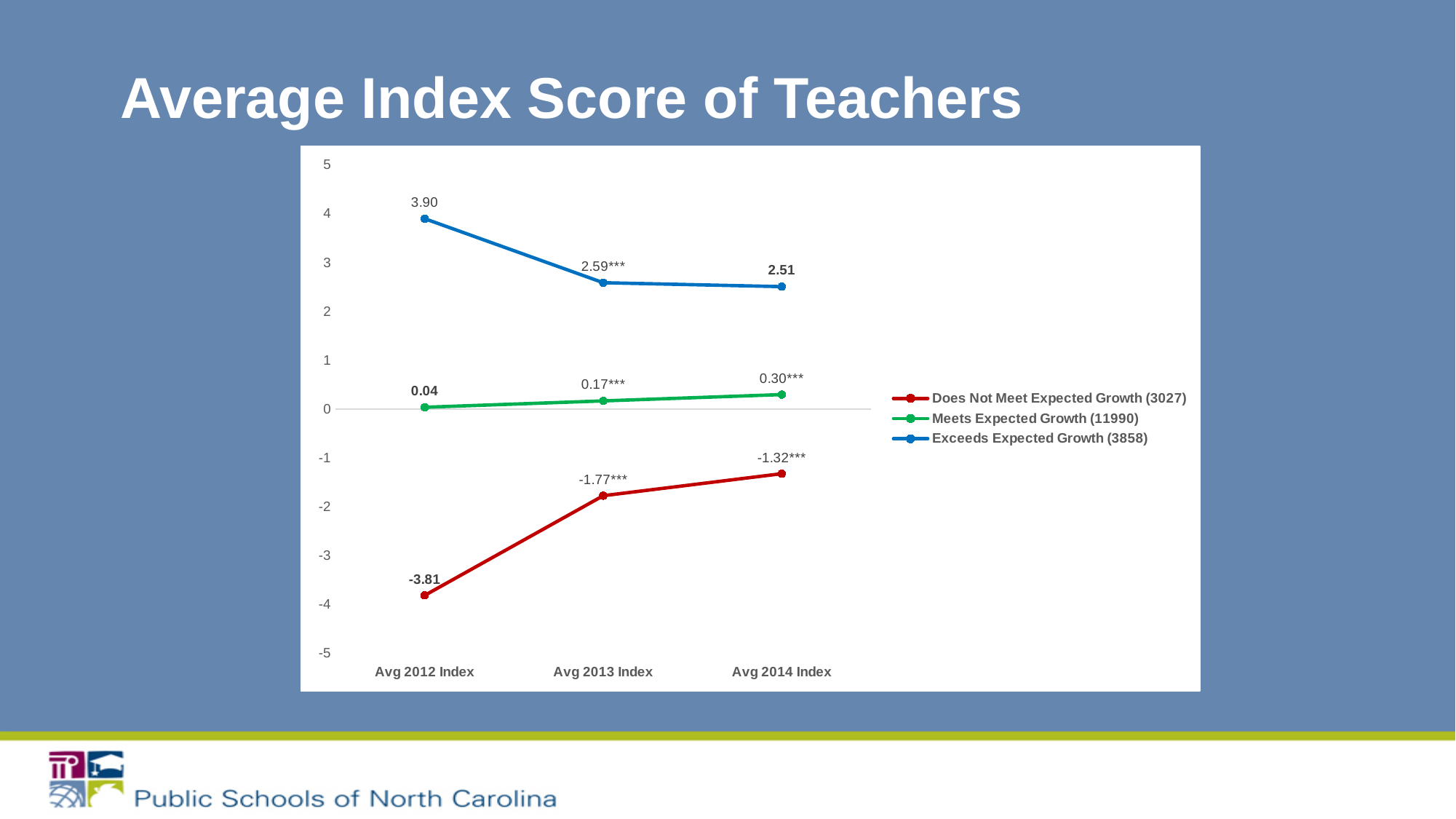
What is the value for Does Not Meet Expected Growth (3027) at Avg 2012 Index? -3.81 At which x-axis category is the Does Not Meet Expected Growth (3027) series lowest? Avg 2012 Index Is the value for Exceeds Expected Growth (3858) at Avg 2014 Index greater or less than 2? greater What is the difference between the Exceeds Expected Growth (3858) values at Avg 2012 Index and Avg 2013 Index? 1.31 At which x-axis category is the Exceeds Expected Growth (3858) series highest? Avg 2012 Index How many categories are shown on the x axis? 3 How many series does the legend list? 3 What kind of chart is shown on the slide? Line chart Which is larger: the Meets Expected Growth (11990) value at Avg 2014 Index or at Avg 2012 Index? Avg 2014 Index What is the value for Does Not Meet Expected Growth (3027) at Avg 2014 Index? -1.32 What is the value for Meets Expected Growth (11990) at Avg 2013 Index? 0.17 What is the value for Exceeds Expected Growth (3858) at Avg 2012 Index? 3.90